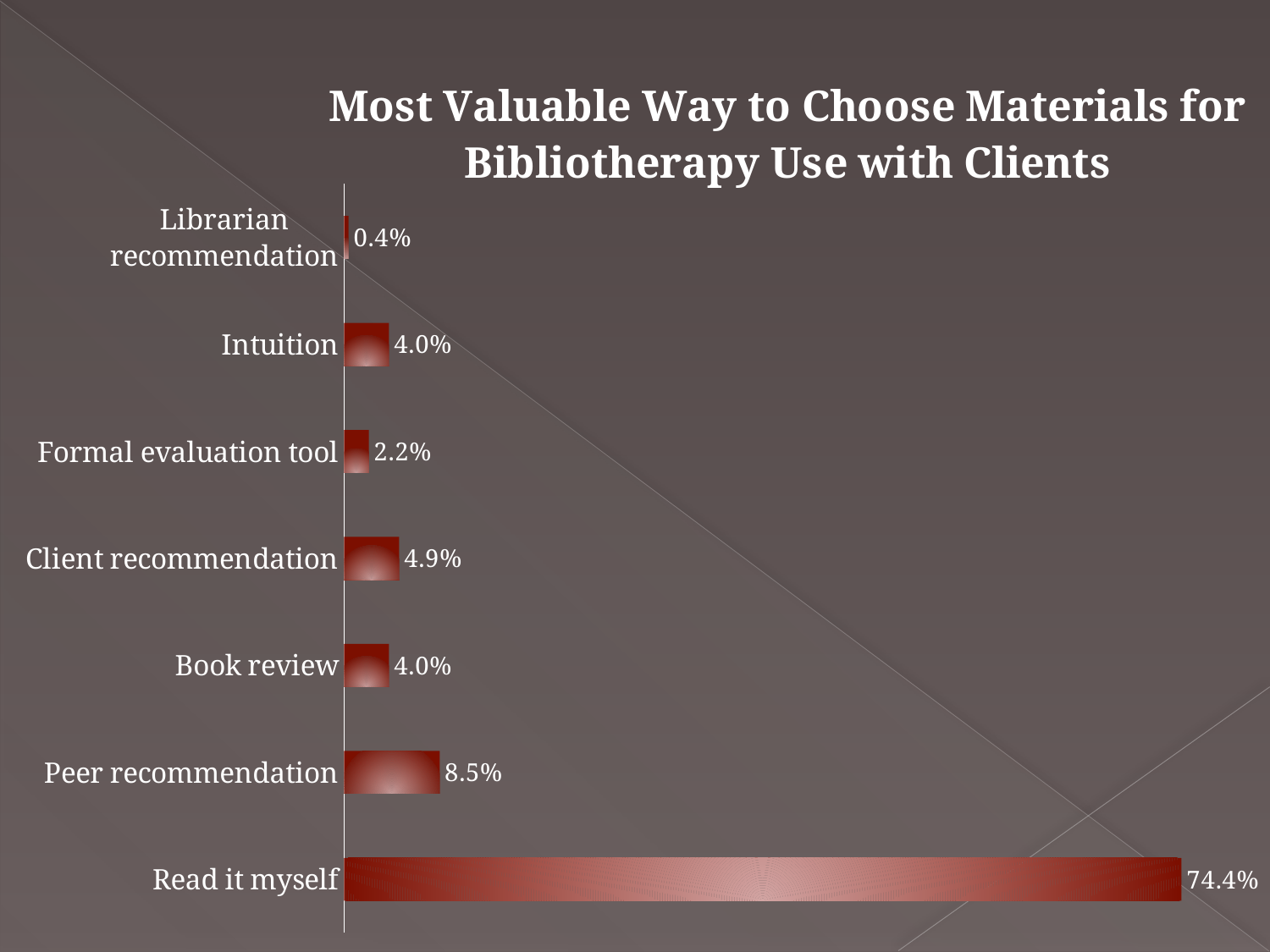
What is the value for Client recommendation? 4.9% Which category has the lowest value? Librarian recommendation What kind of chart is shown on the slide? Bar chart Which category has the highest value? Read it myself Which is larger, the value for Peer recommendation or the value for Book review? Peer recommendation What is the difference between the values for Read it myself and Peer recommendation? 65.9% What is the title of the chart? Most Valuable Way to Choose Materials for Bibliotherapy Use with Clients What is the difference between the values for Client recommendation and Intuition? 0.9% How many categories are shown in the chart? 7 What is the value for Peer recommendation? 8.5% What is the value for Formal evaluation tool? 2.2% What is the value for Read it myself? 74.4%